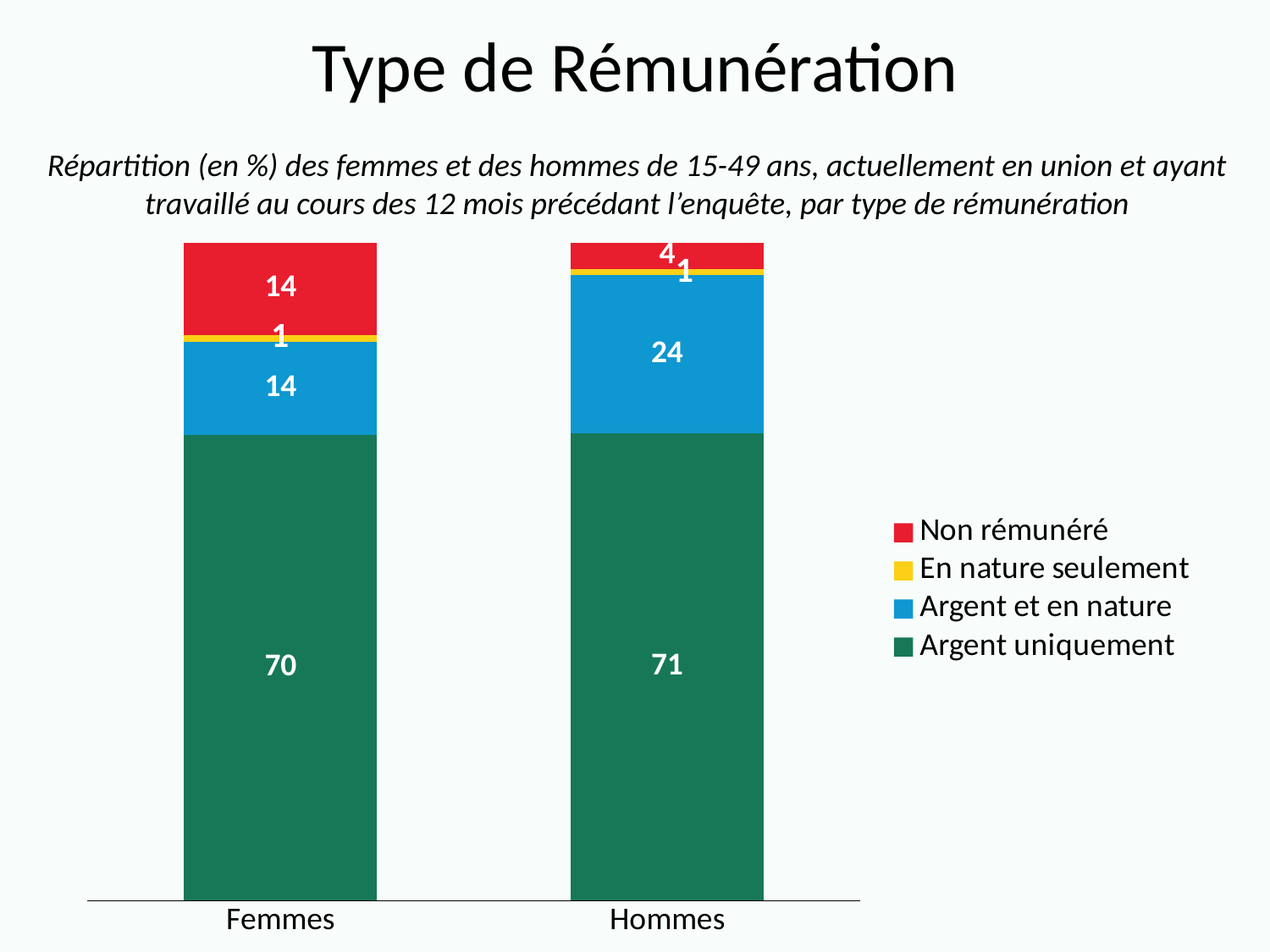
What is the difference between the Argent et en nature values for Hommes and Femmes? 10 What is the value for Non rémunéré for Hommes? 4 What is the value for Argent uniquement for Femmes? 70 What is the value for En nature seulement for Hommes? 1 How many series does the legend list? 4 What is the value for Non rémunéré for Femmes? 14 What kind of chart is shown on the slide? Stacked bar chart What is the value for Argent et en nature for Hommes? 24 What is the difference between the Non rémunéré values for Femmes and Hommes? 10 What is the total of the stacked bar for Femmes? 99 Which category has the higher value for Argent et en nature, Femmes or Hommes? Hommes How many categories are shown on the x axis? 2